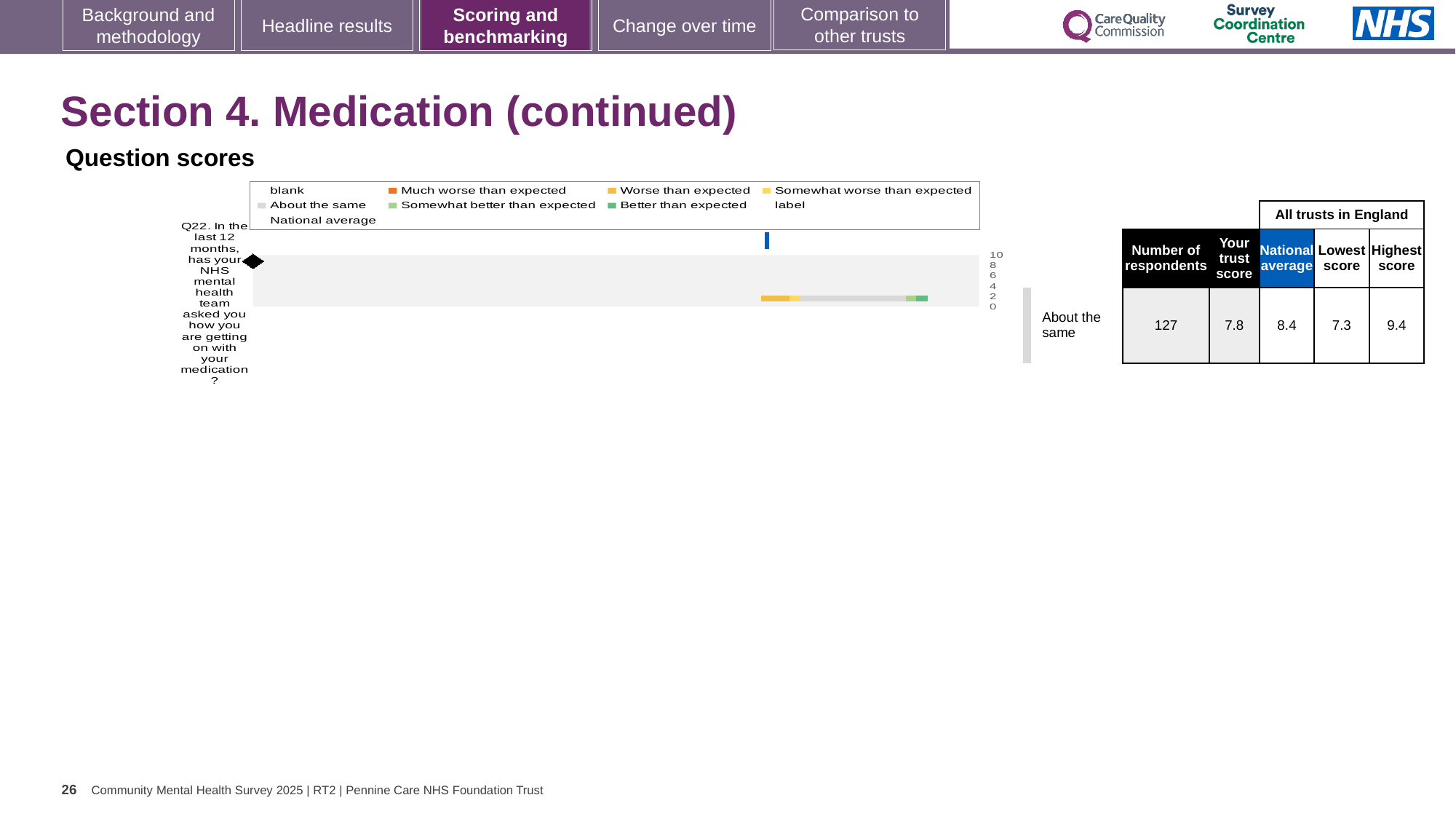
What is the difference between the highest and lowest scores among all trusts in England for Q22? 2.1 What kind of chart is shown under 'Question scores'? bar chart How many respondents answered Q22? 127 What is the national average for Q22 shown alongside the Question scores chart? 8.4 What is the lowest score among all trusts in England for Q22? 7.3 Which question is plotted in the Question scores chart? Q22. In the last 12 months, has your NHS mental health team asked you how you are getting on with your medication? What is the highest score among all trusts in England for Q22? 9.4 Which is larger for Q22, the trust score or the national average? National average What is the difference between the national average and the trust score for Q22? 0.6 How many questions are plotted in the Question scores chart? 1 What is the trust score for Q22 shown alongside the Question scores chart? 7.8 What benchmark category is shown for Q22 in the Question scores chart? About the same